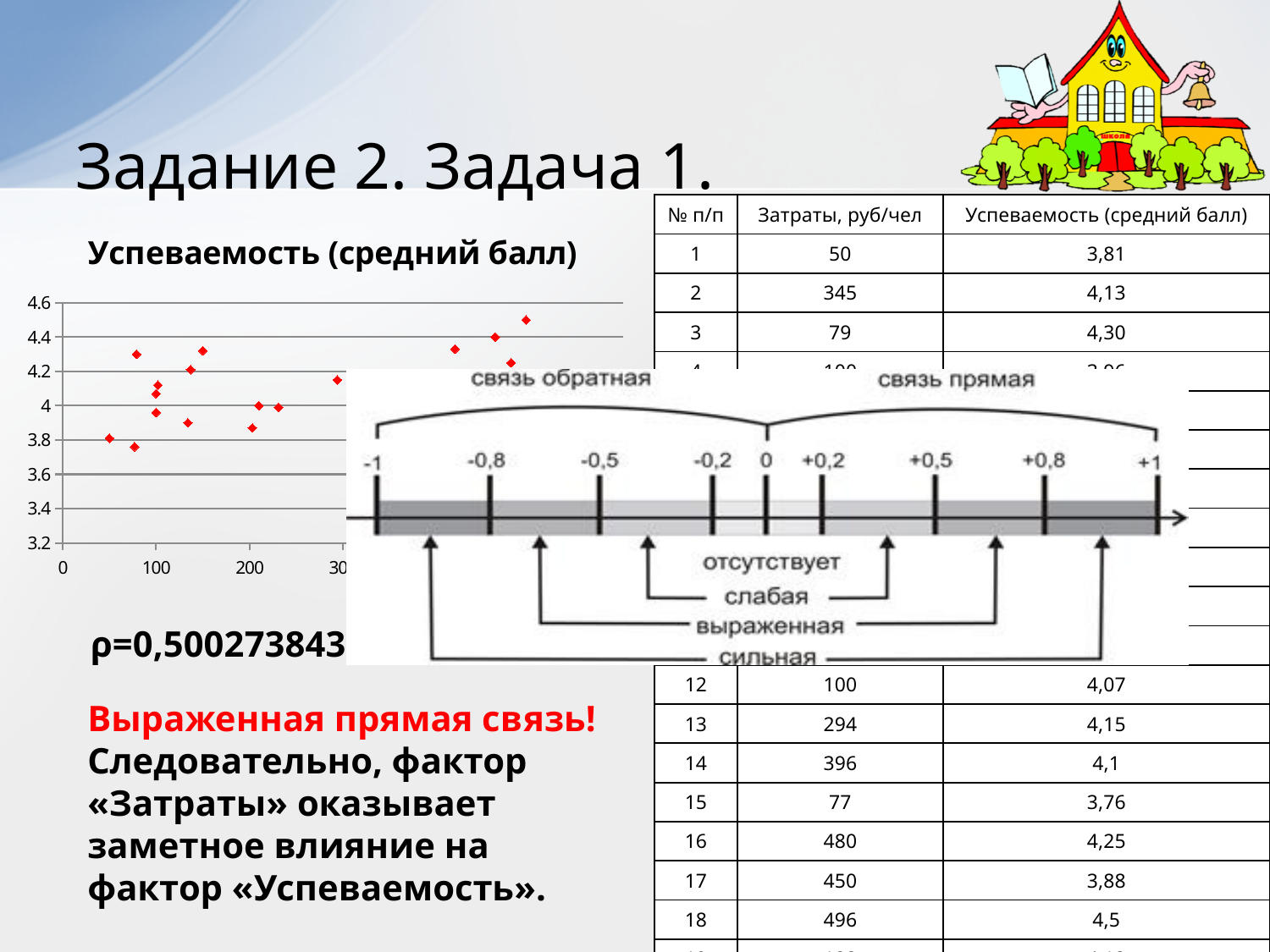
What is the highest value shown on the vertical axis of the chart? 4.6 Is the lowest plotted point in the chart greater or less than 3.6? greater What is the lowest value shown on the vertical axis of the chart? 3.2 What kind of chart is shown on the left of the slide? scatter chart What is the title of the chart on the left of the slide? Успеваемость (средний балл) Is the highest plotted point in the chart greater or less than 4.4? greater Do the plotted points in the chart generally rise or fall as the x-axis value increases? rise